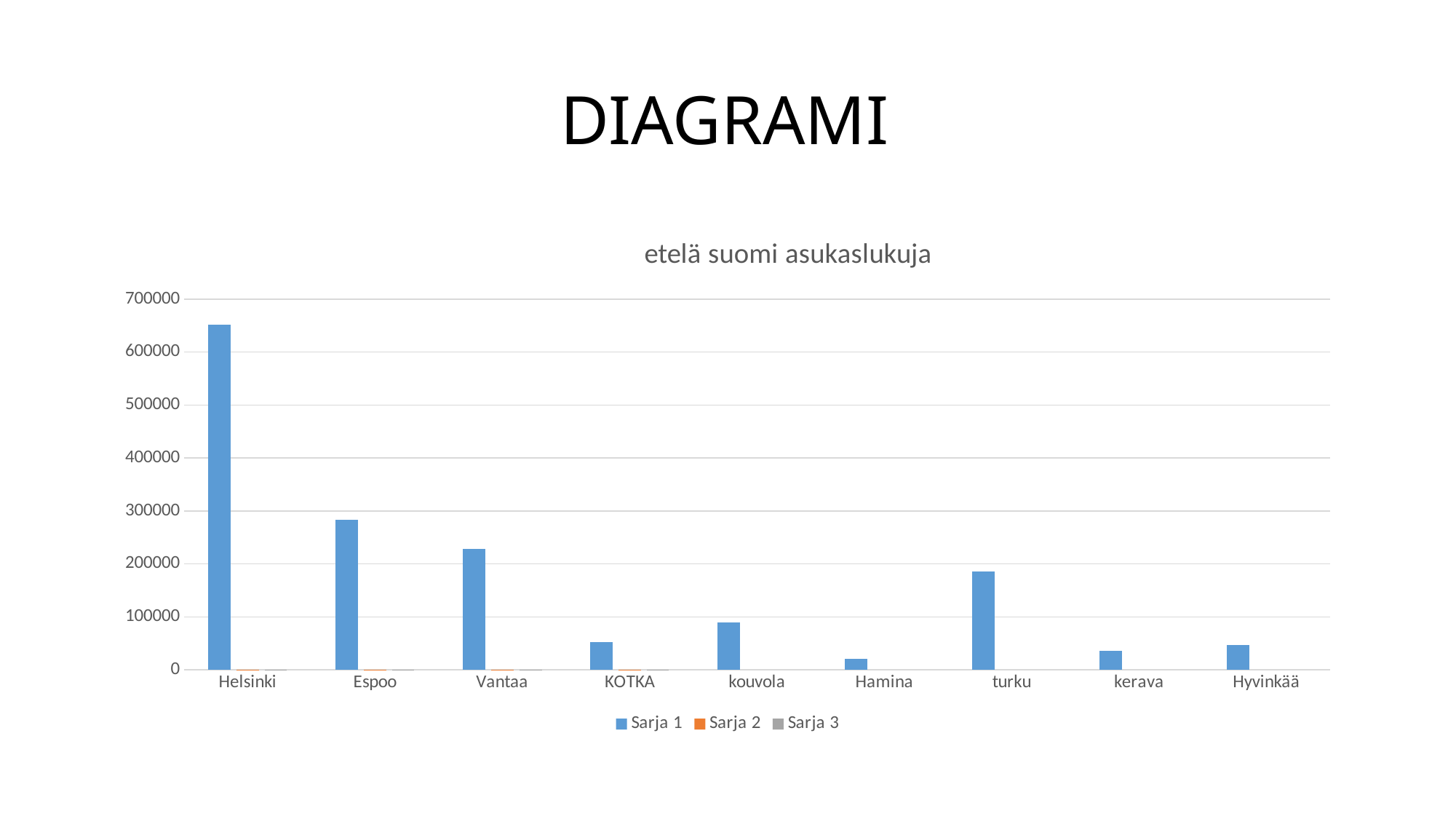
How many series does the legend list? 3 How many categories are shown on the x axis? 9 Which has the larger Sarja 1 value, Espoo or Vantaa? Espoo Is the Sarja 1 value for Vantaa greater or less than 200000? greater Which has the larger Sarja 1 value, turku or kouvola? turku Is the Sarja 1 value for Helsinki greater or less than 600000? greater Is the Sarja 1 value for Espoo greater or less than 300000? less What kind of chart is shown on the slide? bar chart What is the title of the chart? etelä suomi asukaslukuja Which category has the lowest Sarja 1 value? Hamina Which category has the highest Sarja 1 value? Helsinki